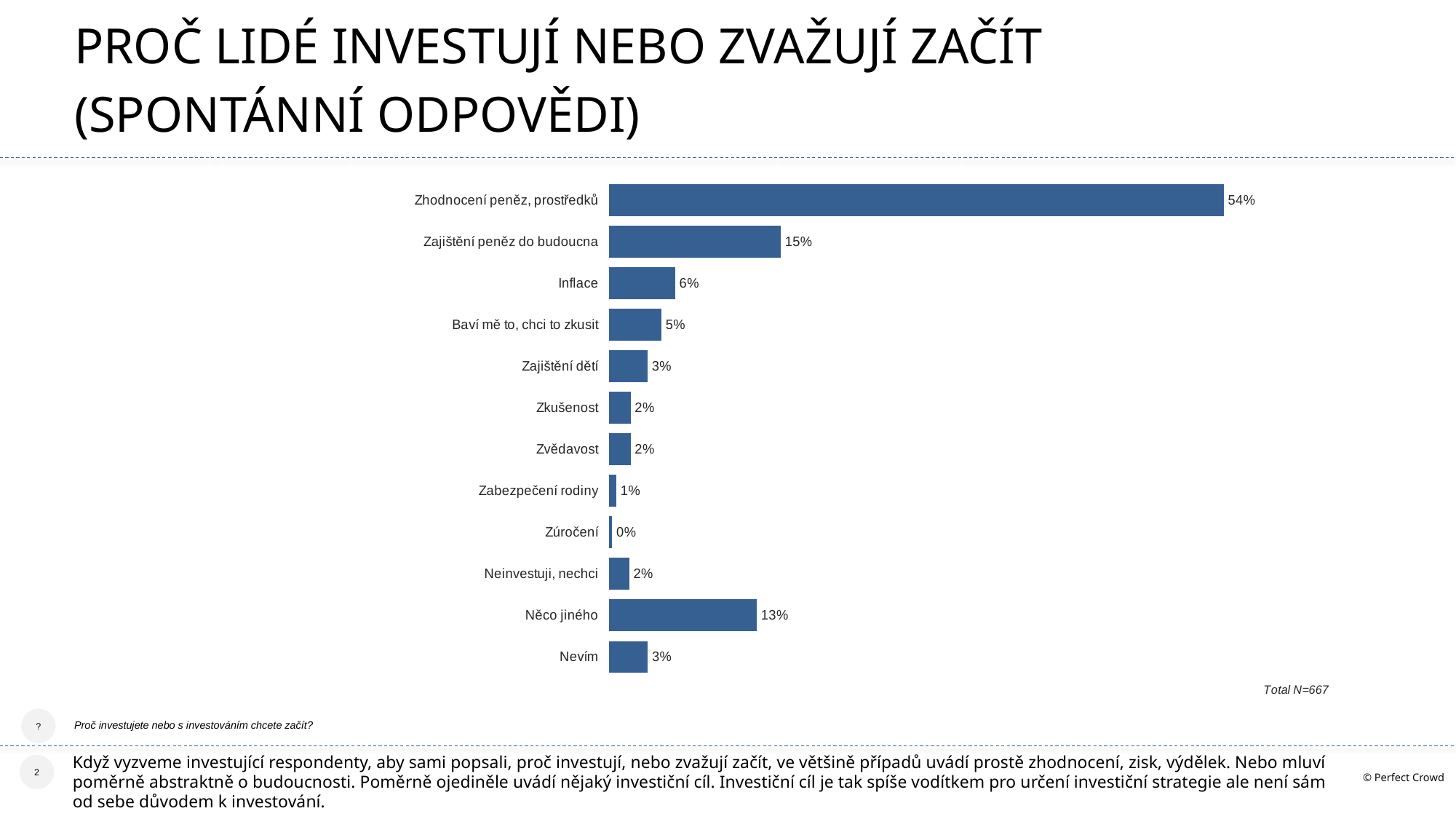
What is the difference between "Zhodnocení peněz, prostředků" and "Zajištění peněz do budoucna"? 39% What is the value for "Něco jiného"? 13% Which category has the lowest value? Zúročení How many categories are shown in the chart? 12 Which category has the highest value? Zhodnocení peněz, prostředků What is the total N stated below the chart? 667 What is the value for "Zajištění peněz do budoucna"? 15% What is the value for "Zhodnocení peněz, prostředků"? 54% What kind of chart is shown on the slide? Bar chart Which is larger, "Něco jiného" or "Zajištění peněz do budoucna"? Zajištění peněz do budoucna What is the value for "Inflace"? 6% What is the difference between "Inflace" and "Baví mě to, chci to zkusit"? 1%